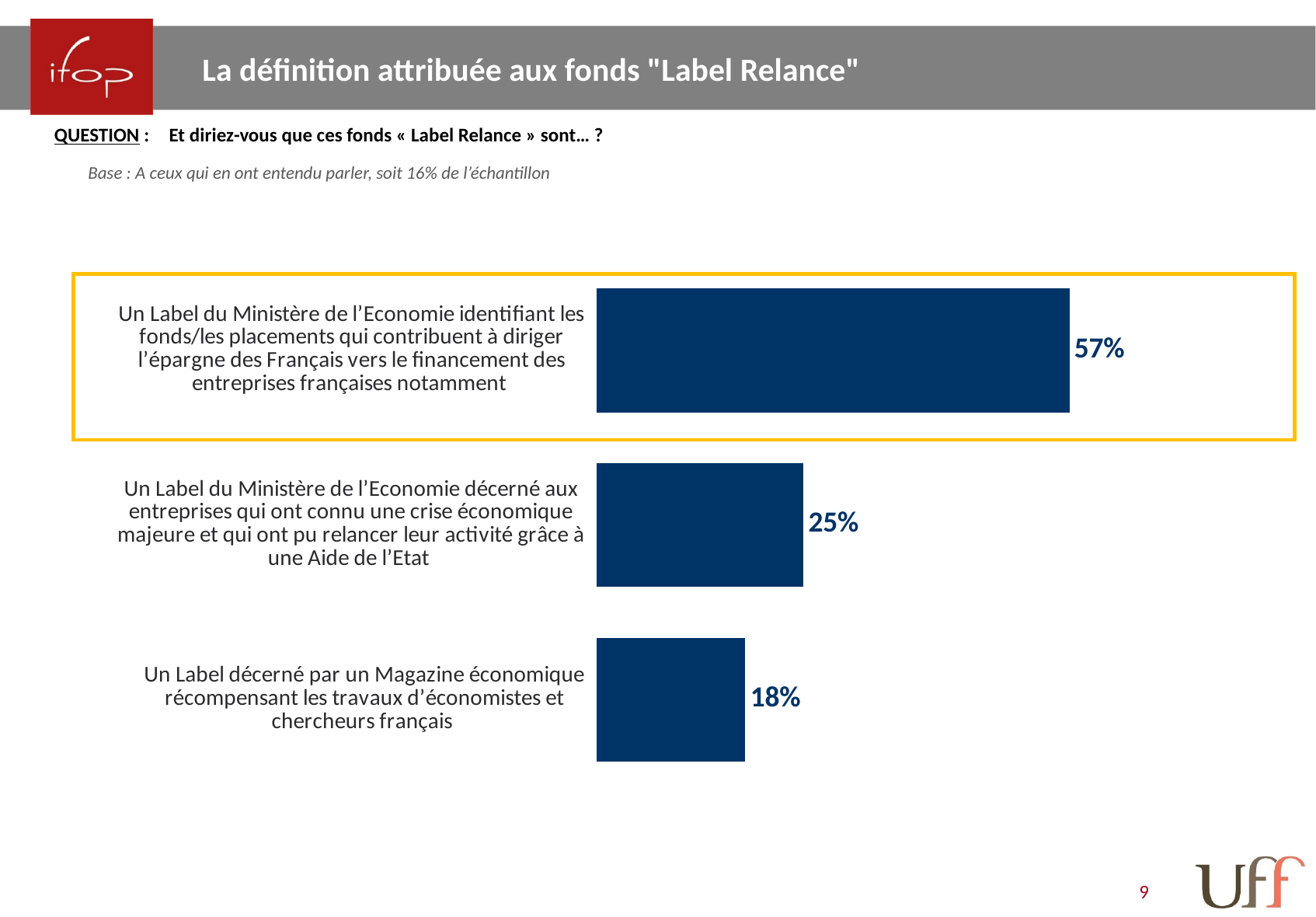
Which received a larger share: the 'Ministère de l'Economie décerné aux entreprises' definition or the 'Magazine économique' definition? Un Label du Ministère de l'Economie décerné aux entreprises qui ont connu une crise économique majeure et qui ont pu relancer leur activité grâce à une Aide de l'Etat How many definitions (categories) are shown in the chart? 3 What is the difference in percentage points between the 'Ministère de l'Economie décerné aux entreprises' definition and the 'Magazine économique' definition? 7 percentage points What is the difference in percentage points between the highest definition (57%) and the lowest definition (18%)? 39 percentage points What is the title of the slide? La définition attribuée aux fonds "Label Relance" Which bar is highlighted with a yellow/orange frame? The 57% bar (Un Label du Ministère de l'Economie identifiant les fonds/les placements...) What percentage of respondents chose the definition 'Un Label décerné par un Magazine économique récompensant les travaux d'économistes et chercheurs français'? 18% Which definition received the lowest percentage? Un Label décerné par un Magazine économique récompensant les travaux d'économistes et chercheurs français What type of chart is shown on the slide? Bar chart What percentage of respondents chose the definition 'Un Label du Ministère de l'Economie identifiant les fonds/les placements qui contribuent à diriger l'épargne des Français vers le financement des entreprises françaises notamment'? 57% Which definition received the highest percentage? Un Label du Ministère de l'Economie identifiant les fonds/les placements qui contribuent à diriger l'épargne des Français vers le financement des entreprises françaises notamment What percentage of respondents chose the definition 'Un Label du Ministère de l'Economie décerné aux entreprises qui ont connu une crise économique majeure et qui ont pu relancer leur activité grâce à une Aide de l'Etat'? 25%